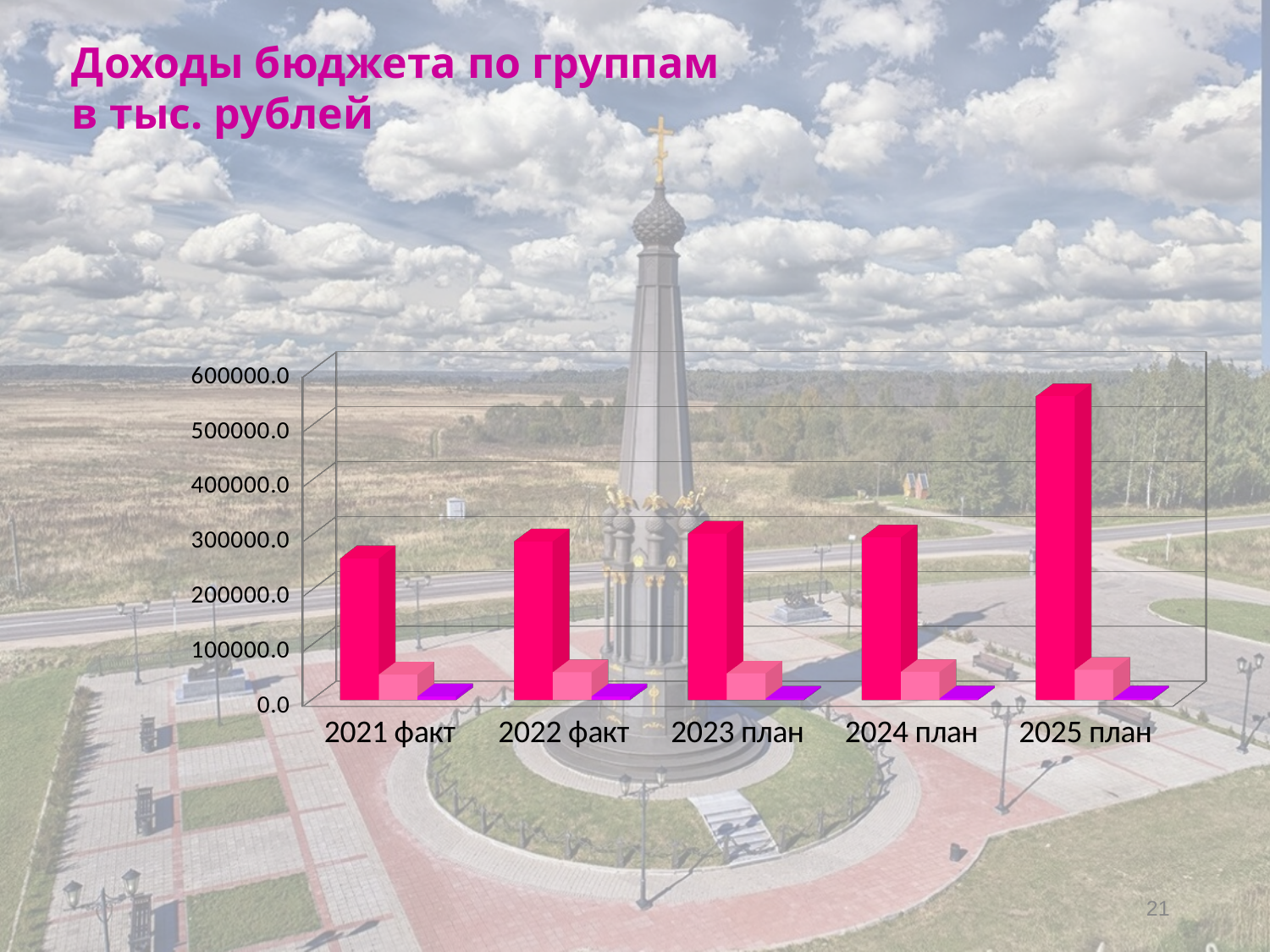
Which has the larger value for the tallest bar: 2022 факт or 2021 факт? 2022 факт Is the value of the tallest bar for 2025 план greater or less than 600000.0? less What kind of chart is shown on the slide? bar chart Is the value of the tallest bar for 2021 факт greater or less than 300000.0? less Is the value of the tallest bar for 2025 план greater or less than 500000.0? greater Among the tallest (magenta) bars, which category has the lowest value? 2021 факт Which has the larger value for the tallest bar: 2025 план or 2021 факт? 2025 план How many categories are shown along the x axis of the chart? 5 Which category has the tallest bar in the chart? 2025 план What is the title of the chart on the slide? Доходы бюджета по группам в тыс. рублей What is the highest value shown on the y axis of the chart? 600000.0